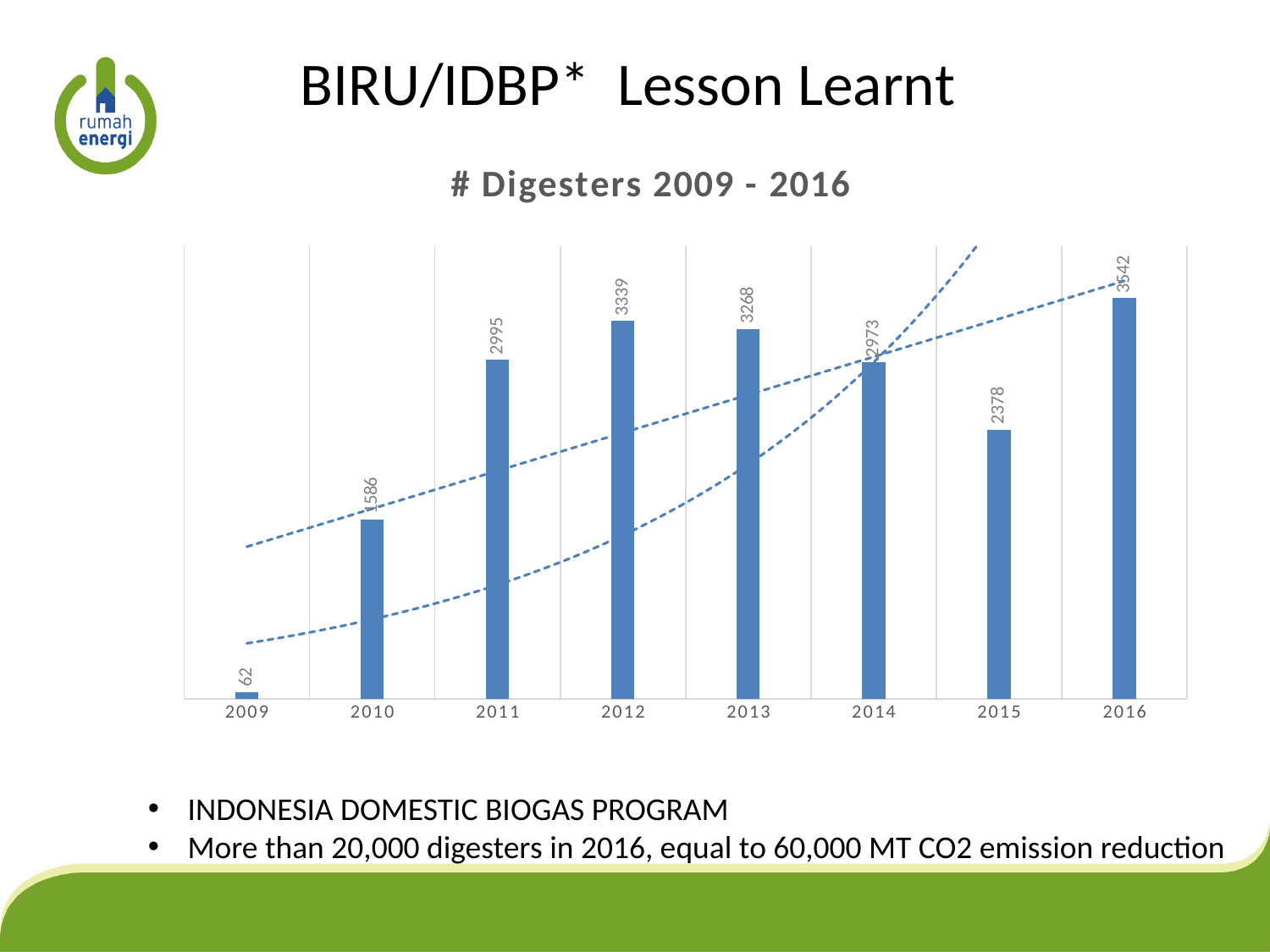
What is the value for 2015? 2378 Do the values rise or fall from 2012 to 2015? fall What is the value for 2009? 62 Which year has the lowest number of digesters? 2009 Which year has the highest number of digesters? 2016 What kind of chart is shown on the slide? bar chart Which is larger, the value for 2013 or the value for 2014? 2013 How many years are shown on the x axis? 8 What is the title of the chart? # Digesters 2009 - 2016 What is the difference between the values for 2016 and 2015? 1164 What is the difference between the values for 2010 and 2009? 1524 How many digesters are shown for 2012? 3339